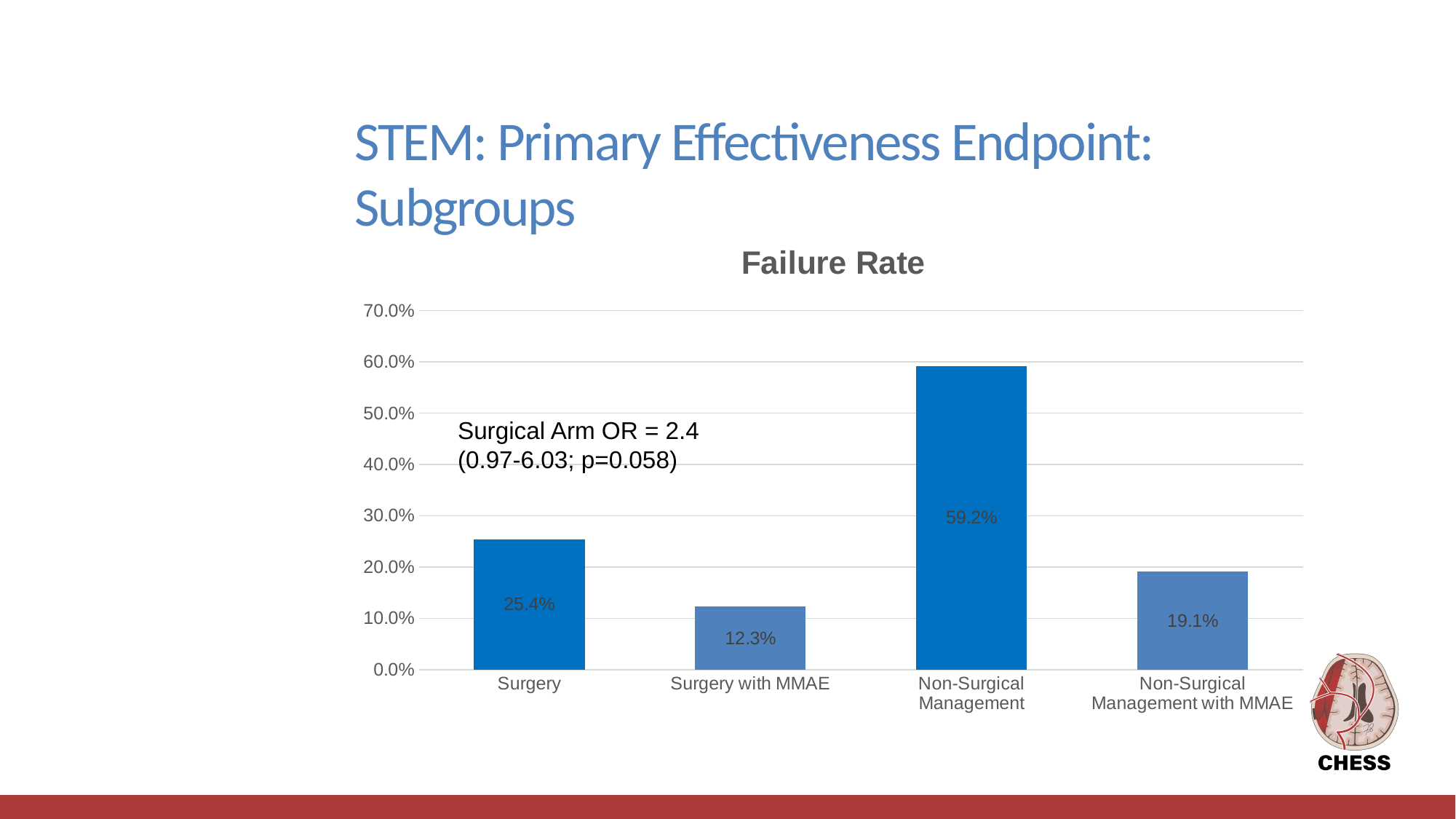
What is the title of the chart? Failure Rate What is the difference in failure rate between Non-Surgical Management and Non-Surgical Management with MMAE? 40.1% What is the failure rate for Non-Surgical Management? 59.2% Which category has the highest failure rate? Non-Surgical Management What type of chart is shown on the slide? Bar chart What is the failure rate for Surgery? 25.4% How many categories are shown on the chart? 4 Which category has the lowest failure rate? Surgery with MMAE Which has a higher failure rate, Surgery or Non-Surgical Management with MMAE? Surgery What is the failure rate for Non-Surgical Management with MMAE? 19.1% What is the failure rate for Surgery with MMAE? 12.3% What is the difference in failure rate between Surgery and Surgery with MMAE? 13.1%